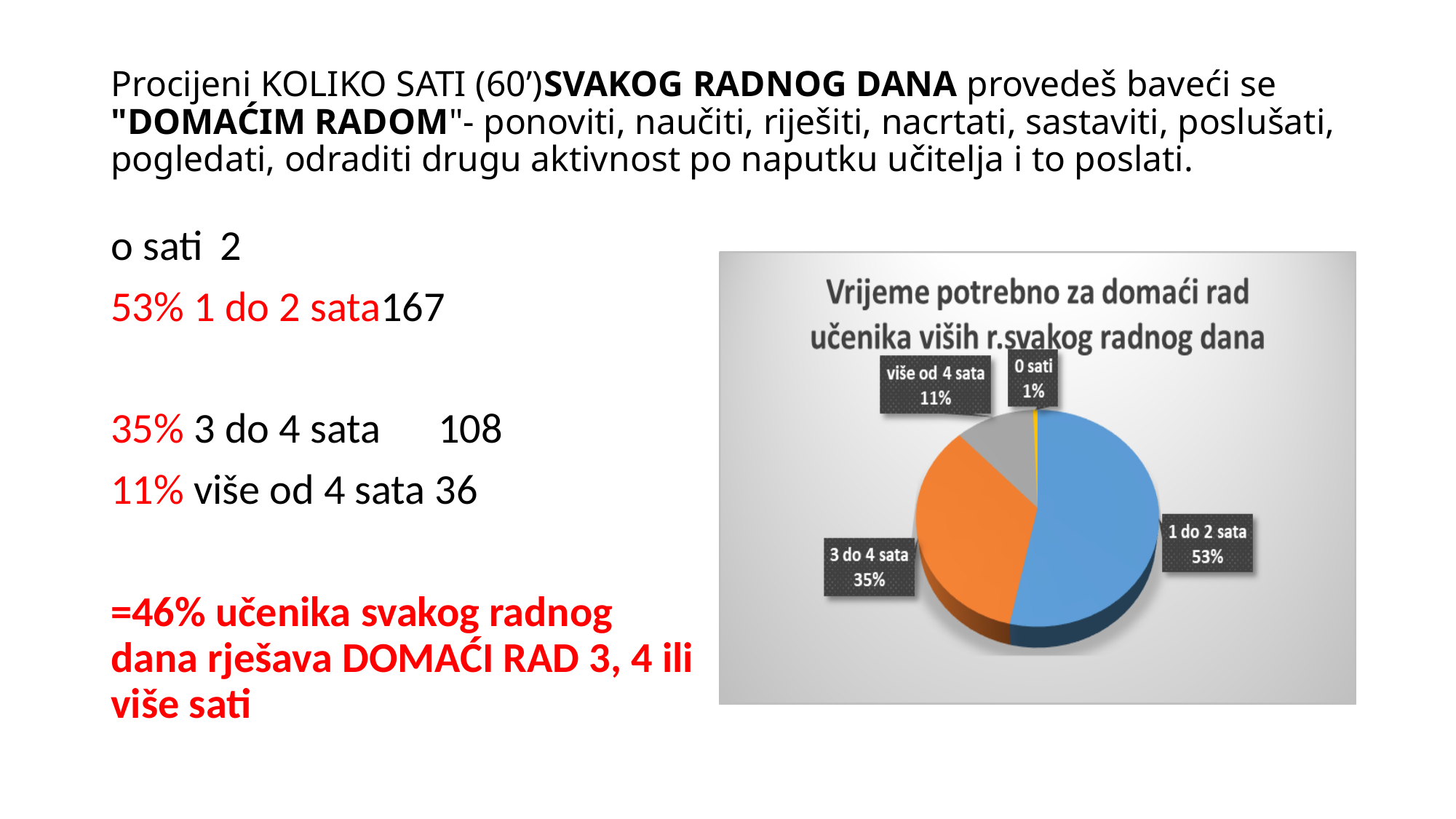
What is the title of the chart? Vrijeme potrebno za domaći rad učenika viših r.svakog radnog dana What share of the pie does the '1 do 2 sata' slice represent? 53% Which slice is larger, '3 do 4 sata' or 'više od 4 sata'? 3 do 4 sata What share of the pie does the 'više od 4 sata' slice represent? 11% What colour is the '1 do 2 sata' slice? blue What share of the pie does the '3 do 4 sata' slice represent? 35% What is the difference in percentage points between the '1 do 2 sata' and '3 do 4 sata' slices? 18% What kind of chart is shown on the slide? pie chart How many slices does the pie chart have? 4 Which category has the smallest slice of the pie? 0 sati Which category has the largest slice of the pie? 1 do 2 sata